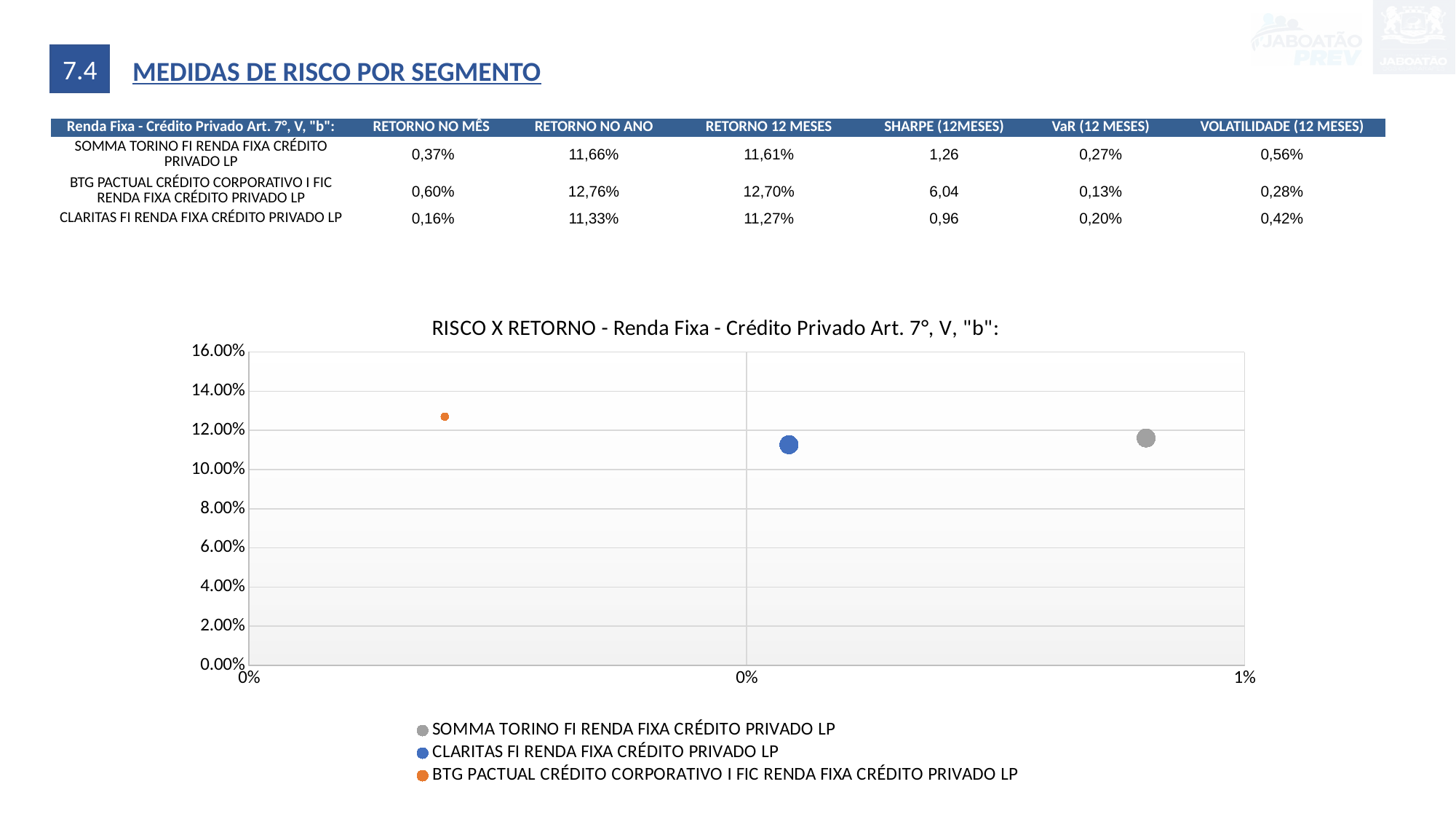
On the RISCO X RETORNO chart, which is plotted higher on the vertical axis: BTG PACTUAL CRÉDITO CORPORATIVO I FIC RENDA FIXA CRÉDITO PRIVADO LP or CLARITAS FI RENDA FIXA CRÉDITO PRIVADO LP? BTG PACTUAL CRÉDITO CORPORATIVO I FIC RENDA FIXA CRÉDITO PRIVADO LP On the RISCO X RETORNO chart, is the vertical-axis value for SOMMA TORINO FI RENDA FIXA CRÉDITO PRIVADO LP greater or less than 10.00%? greater On the RISCO X RETORNO chart, is the vertical-axis value for BTG PACTUAL CRÉDITO CORPORATIVO I FIC RENDA FIXA CRÉDITO PRIVADO LP greater or less than 12.00%? greater How many series does the legend of the RISCO X RETORNO chart list? 3 How many data points are plotted on the RISCO X RETORNO chart? 3 Which fund's point is furthest to the left on the horizontal axis of the RISCO X RETORNO chart? BTG PACTUAL CRÉDITO CORPORATIVO I FIC RENDA FIXA CRÉDITO PRIVADO LP Which fund's point is furthest to the right on the horizontal axis of the RISCO X RETORNO chart? SOMMA TORINO FI RENDA FIXA CRÉDITO PRIVADO LP What colour is the marker for SOMMA TORINO FI RENDA FIXA CRÉDITO PRIVADO LP in the RISCO X RETORNO chart legend? gray Which fund has the highest point on the vertical axis of the RISCO X RETORNO chart? BTG PACTUAL CRÉDITO CORPORATIVO I FIC RENDA FIXA CRÉDITO PRIVADO LP What kind of chart is "RISCO X RETORNO - Renda Fixa - Crédito Privado Art. 7°, V, "b":"? scatter (bubble) chart What is the title of the chart on the slide? RISCO X RETORNO - Renda Fixa - Crédito Privado Art. 7°, V, "b": On the RISCO X RETORNO chart, is the vertical-axis value for CLARITAS FI RENDA FIXA CRÉDITO PRIVADO LP greater or less than 12.00%? less